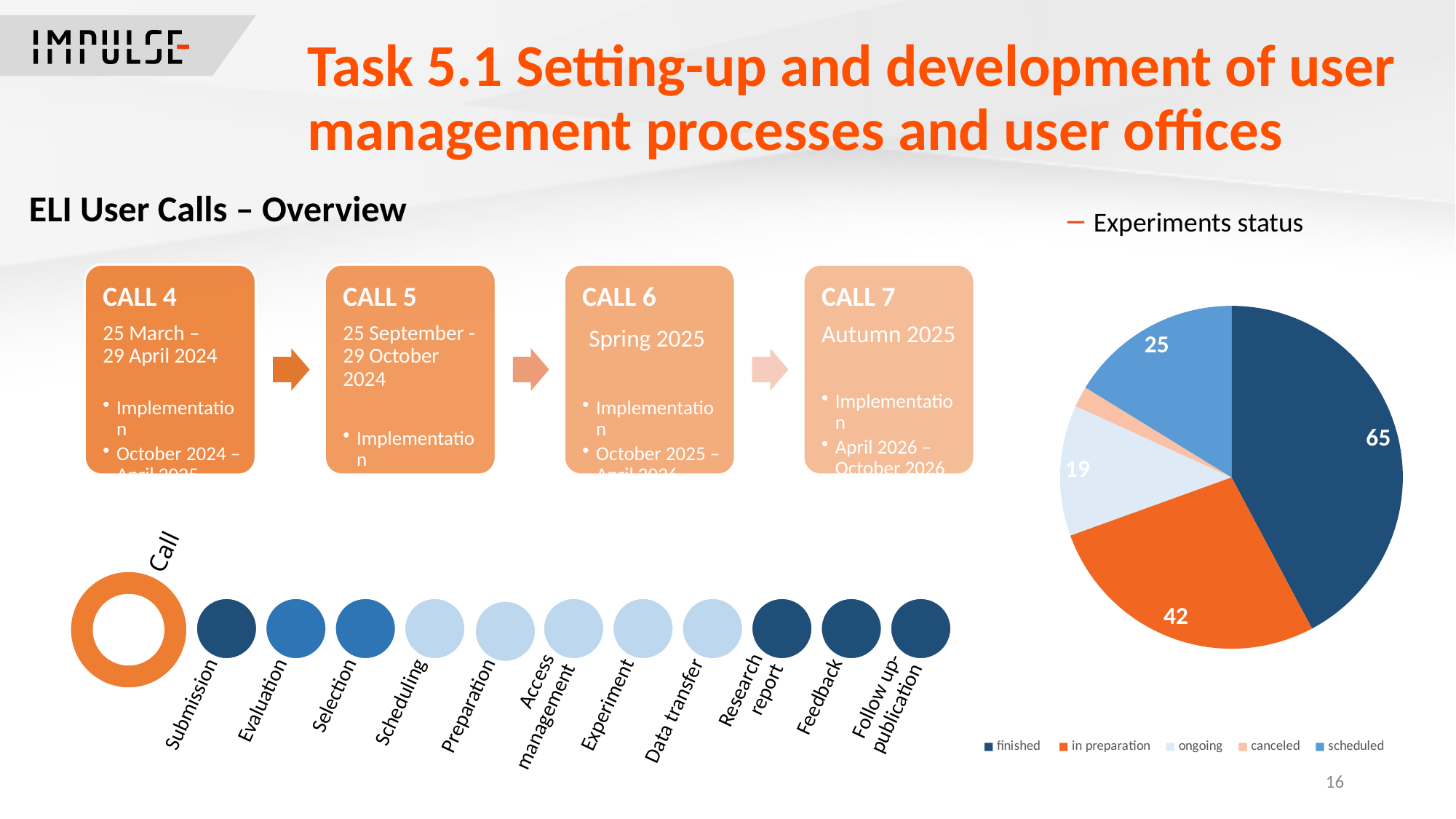
In the Experiments status pie chart, what is the value for finished? 65 What type of chart is the Experiments status chart? pie chart In the Experiments status pie chart, which is larger: in preparation or scheduled? in preparation In the Experiments status pie chart, what is the difference between the scheduled and ongoing values? 6 In the Experiments status pie chart, what is the value for scheduled? 25 Which category has the largest slice in the Experiments status pie chart? finished Which category has the smallest slice in the Experiments status pie chart? canceled What is the title of the pie chart on the slide? Experiments status How many categories does the legend of the Experiments status pie chart list? 5 In the Experiments status pie chart, what is the value for ongoing? 19 In the Experiments status pie chart, what is the difference between the finished and in preparation values? 23 In the Experiments status pie chart, what is the value for in preparation? 42